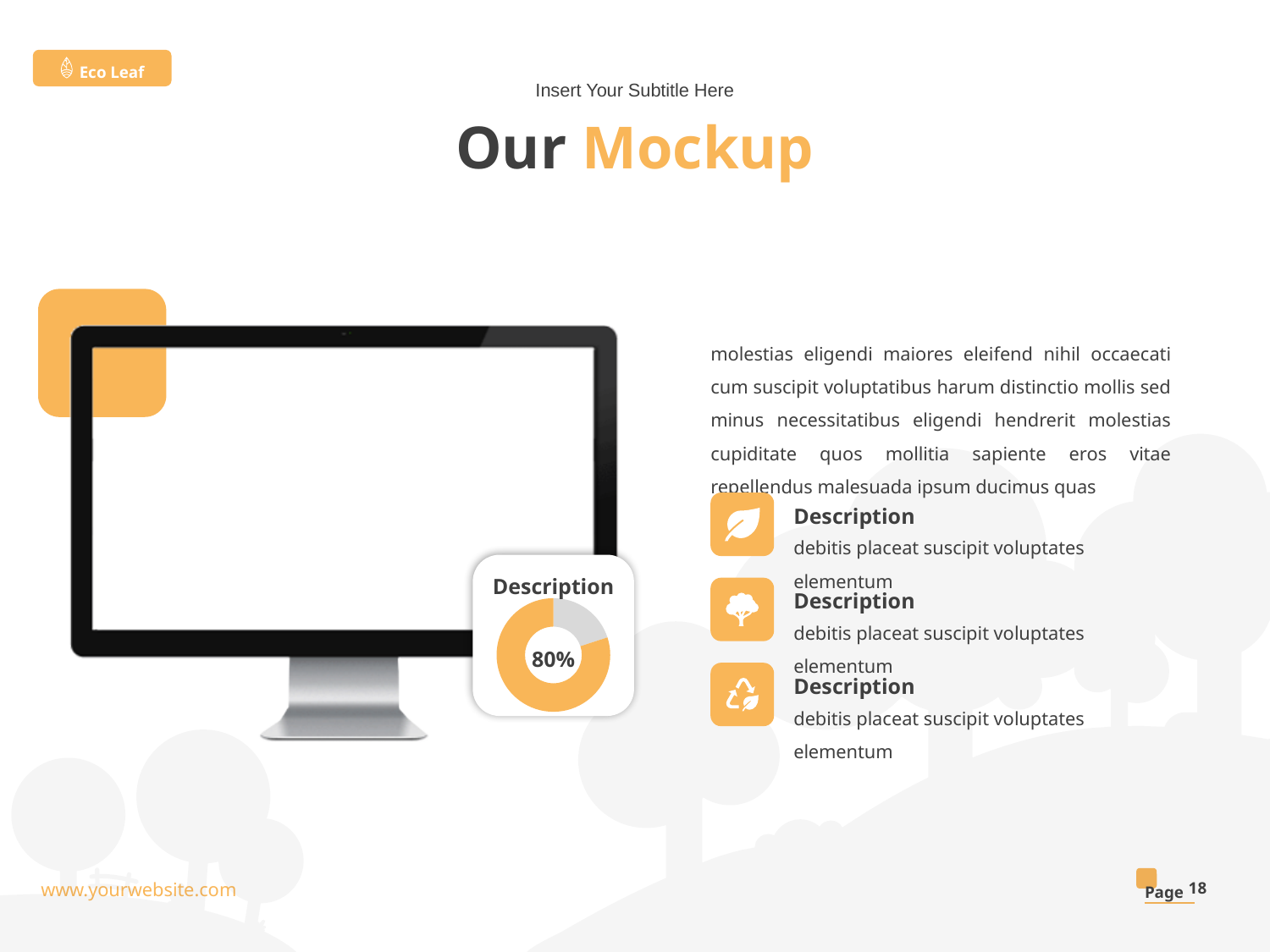
Which segment of the doughnut chart is larger, the orange one or the grey one? The orange one What percentage is printed in the centre of the doughnut chart? 80% How many segments does the doughnut chart have? 2 What is the title shown above the doughnut chart? Description Is the value shown in the doughnut chart greater or less than 50%? greater What kind of chart is shown in the card next to the monitor? Doughnut chart What colour is the larger segment of the doughnut chart? Orange